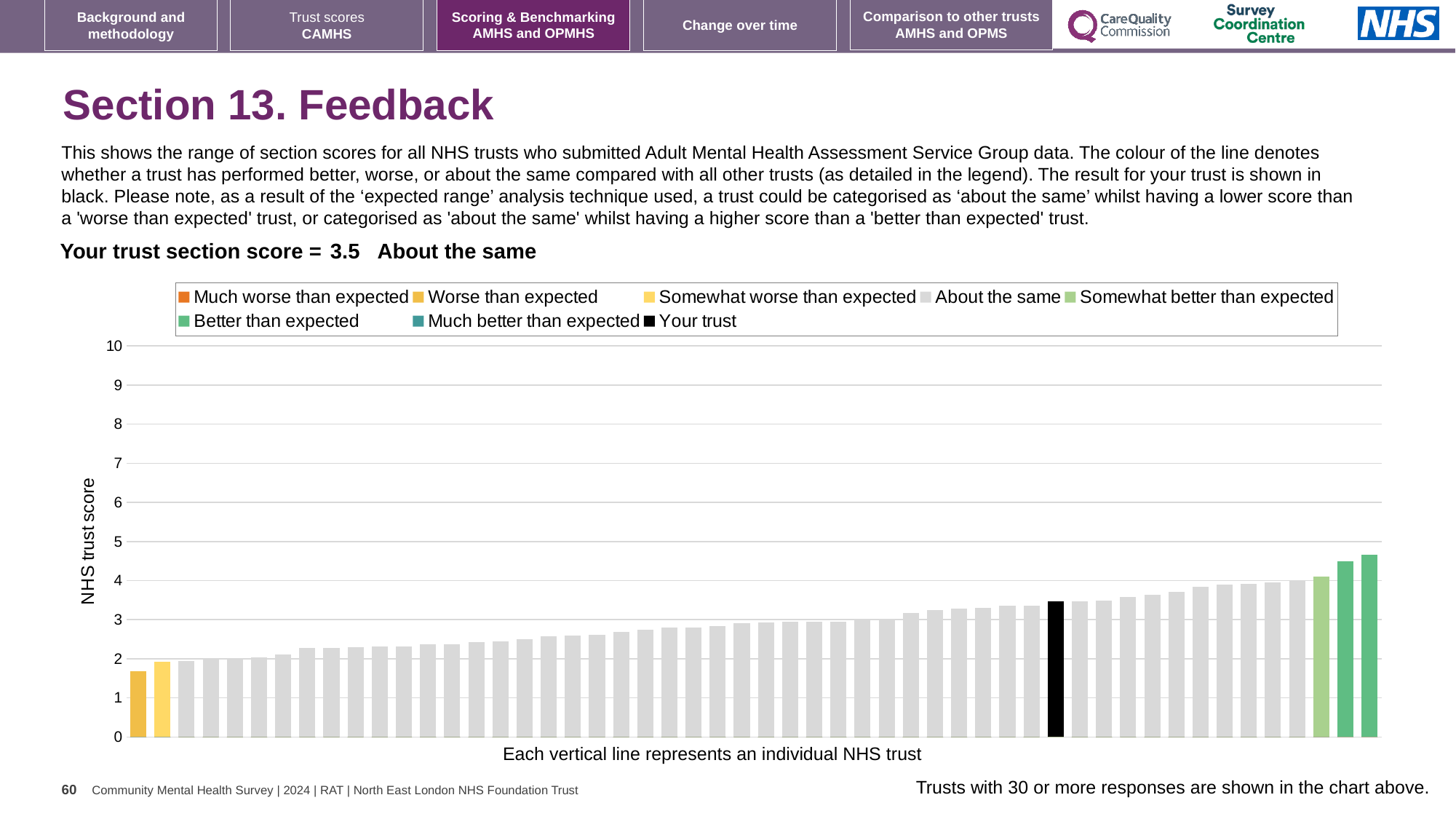
How many entries does the chart legend list? 8 Is the value of the shortest bar greater or less than 2? less Is the value of the tallest bar greater or less than 4? greater Do the bar heights rise or fall from left to right across the chart? rise Which is larger, the bar for your trust or the leftmost bar in the chart? your trust Is the value for your trust greater or less than 5? less What colour is the bar representing your trust? black What is the label on the vertical axis of the chart? NHS trust score How many bars in the chart are shaded green? 3 Which category is your trust's section score placed in? About the same What is the section score for your trust shown on the slide? 3.5 What kind of chart is shown on the slide? bar chart